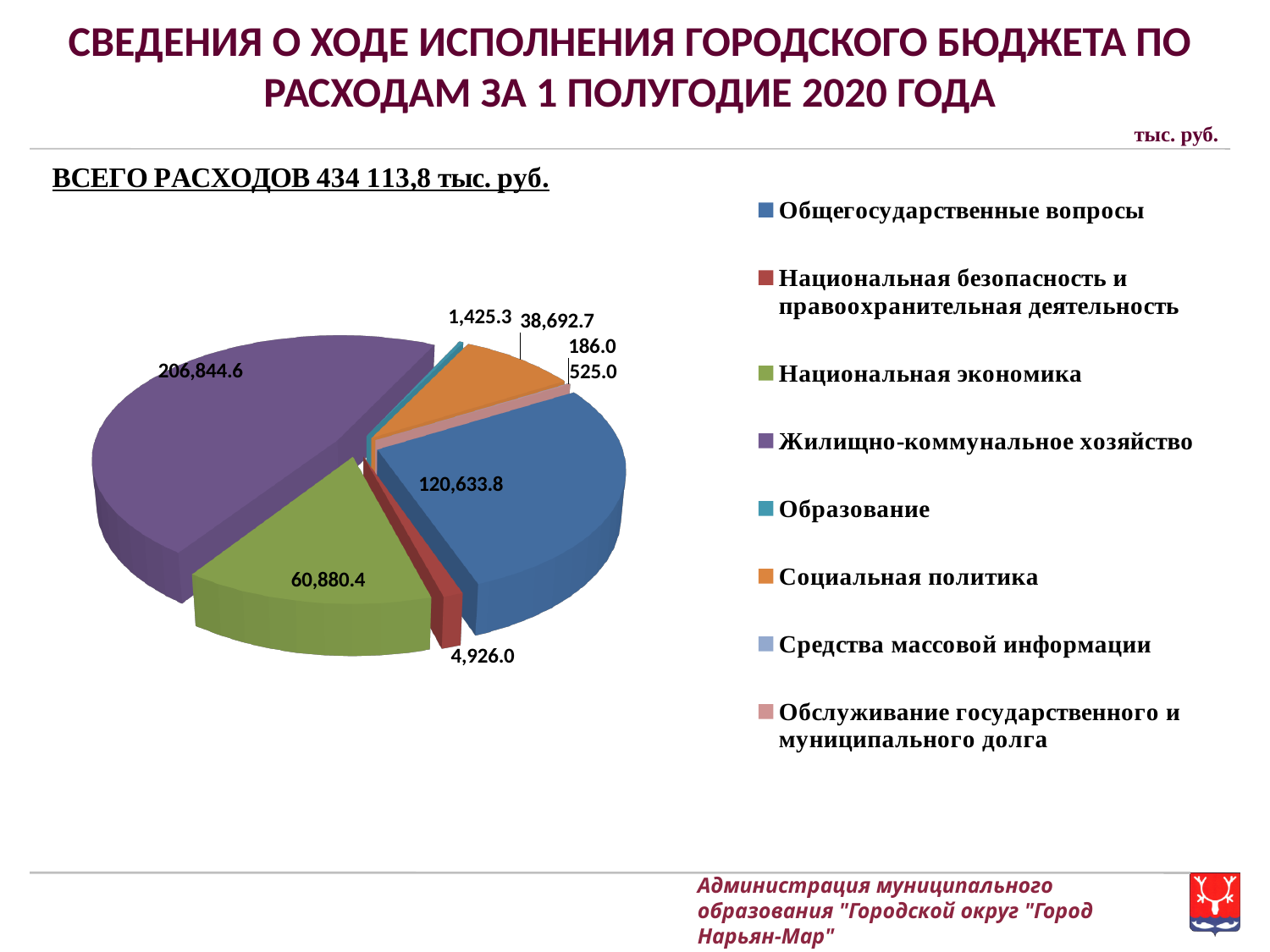
What is the value for Образование? 1,425.3 What is the value for Национальная экономика? 60,880.4 Which category has the smallest value shown on the chart? Средства массовой информации What is the value for Общегосударственные вопросы? 120,633.8 What type of chart is shown on the slide? Pie chart What is the value for Жилищно-коммунальное хозяйство? 206,844.6 What is the value for Национальная безопасность и правоохранительная деятельность? 4,926.0 How many categories does the legend list? 8 Which category has the largest slice of the pie? Жилищно-коммунальное хозяйство Which is larger, Национальная экономика or Социальная политика? Национальная экономика What is the value for Социальная политика? 38,692.7 What is the difference between the values for Жилищно-коммунальное хозяйство and Общегосударственные вопросы? 86,210.8